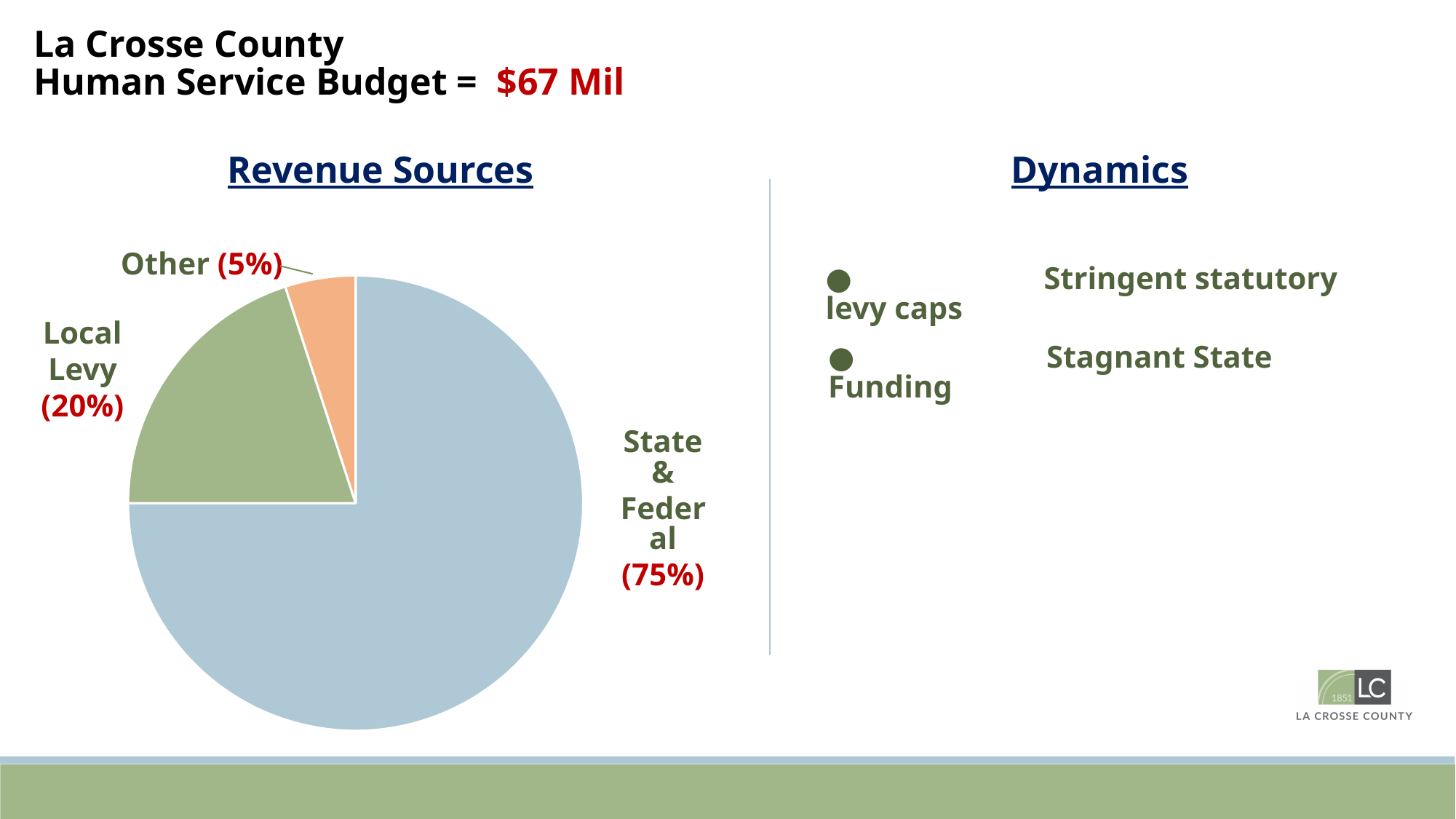
What share of revenue comes from the Local Levy? 20% Which revenue source is the largest slice of the pie? State & Federal What colour is the State & Federal slice of the pie? light blue What is the difference in percentage points between the State & Federal share and the Local Levy share? 55 Which revenue source is the smallest slice of the pie? Other What kind of chart is shown under Revenue Sources? pie chart Which is larger, the Local Levy share or the Other share? Local Levy What is the difference in percentage points between the Local Levy share and the Other share? 15 What share of revenue comes from Other sources? 5% How many slices does the Revenue Sources pie chart have? 3 What share of revenue comes from State & Federal sources? 75% What is the title of the pie chart? Revenue Sources